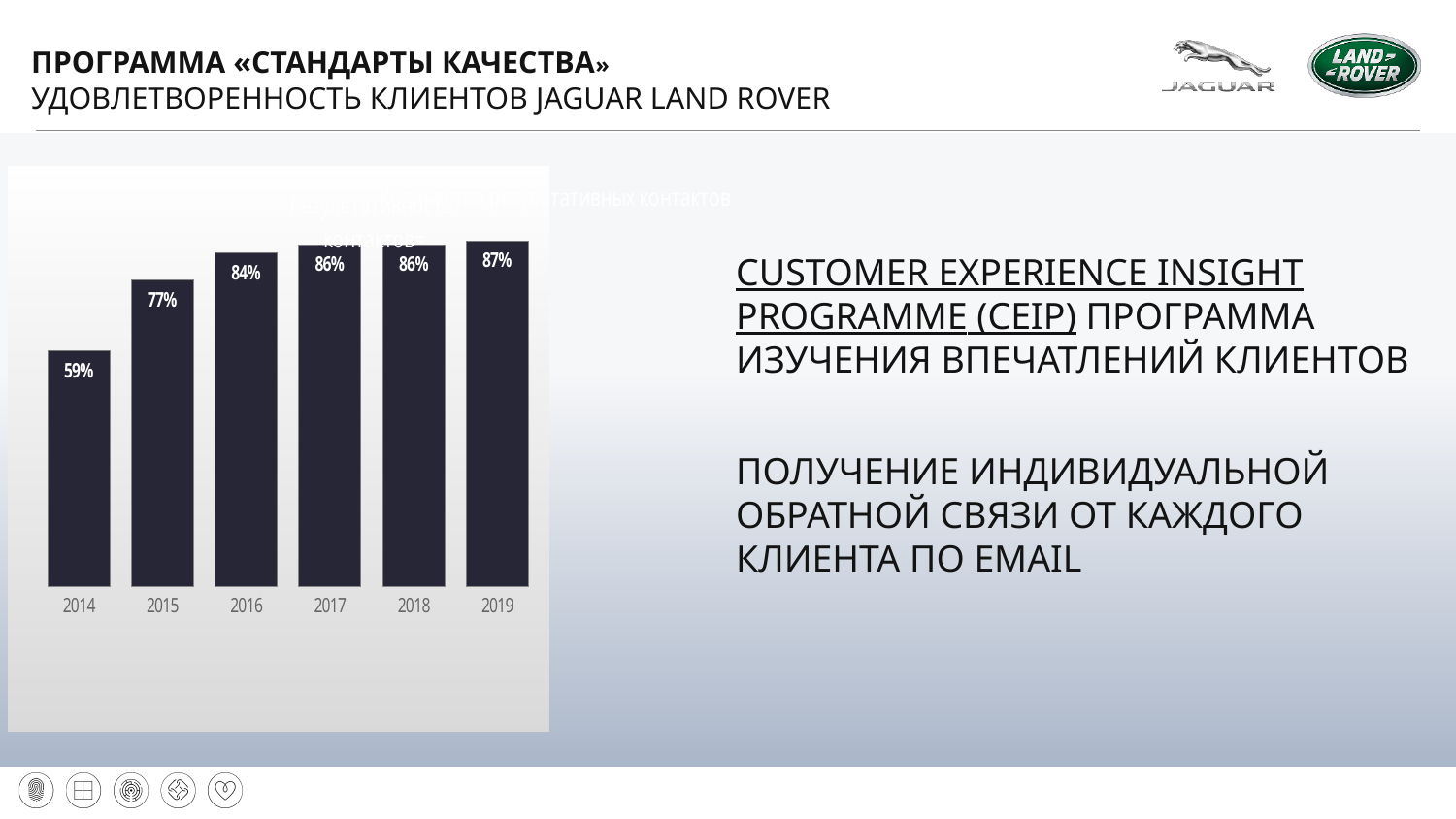
Which year has the lowest value? 2014 What is the difference between the values for 2015 and 2014? 18% What is the value for 2016? 84% What is the difference between the values for 2019 and 2014? 28% What kind of chart is shown on the slide? Bar chart Do the values rise or fall from 2014 to 2019? Rise Which is larger, the value for 2016 or the value for 2015? 2016 Which year has the highest value? 2019 How many years are shown on the x axis? 6 What is the value for 2019? 87% What is the value for 2014? 59% What is the value for 2015? 77%